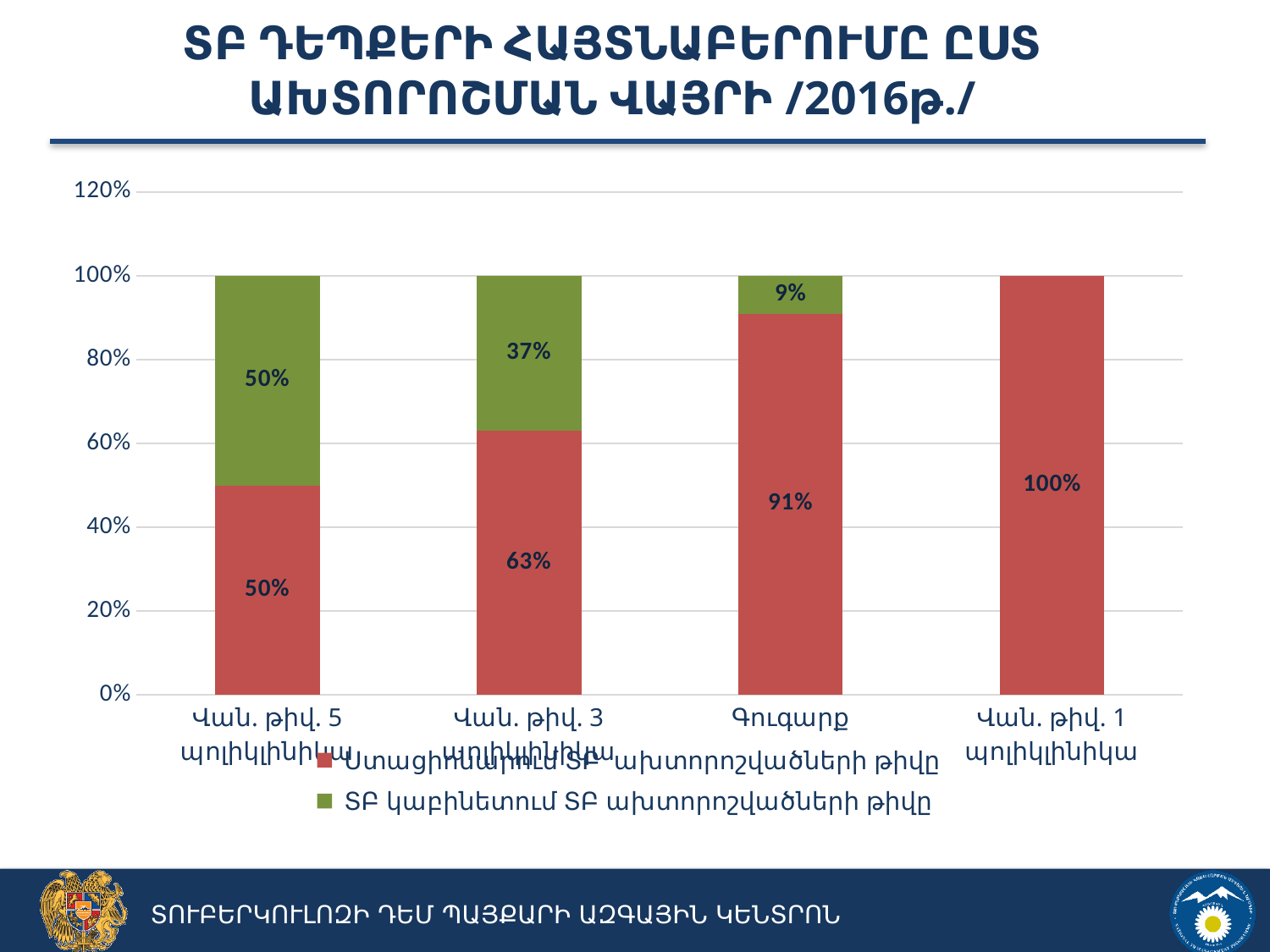
What is the total of the stacked bar for Վան. թիվ. 3 պոլիկլինիկա? 100% What is the value of the red segment for Վան. թիվ. 1 պոլիկլինիկա? 100% How many series does the legend list? 2 What is the difference between the red segment values for Գուգարք and Վան. թիվ. 3 պոլիկլինիկա? 28% Which category has the largest green segment? Վան. թիվ. 5 պոլիկլինիկա What is the value of the red segment for Գուգարք? 91% What is the value of the green segment for Վան. թիվ. 3 պոլիկլինիկա? 37% Which category has the smallest red segment? Վան. թիվ. 5 պոլիկլինիկա How many categories are shown on the x axis? 4 What kind of chart is shown on the slide? Stacked bar chart Is the red segment larger for Վան. թիվ. 3 պոլիկլինիկա or for Գուգարք? Գուգարք What is the value of the green segment for Գուգարք? 9%